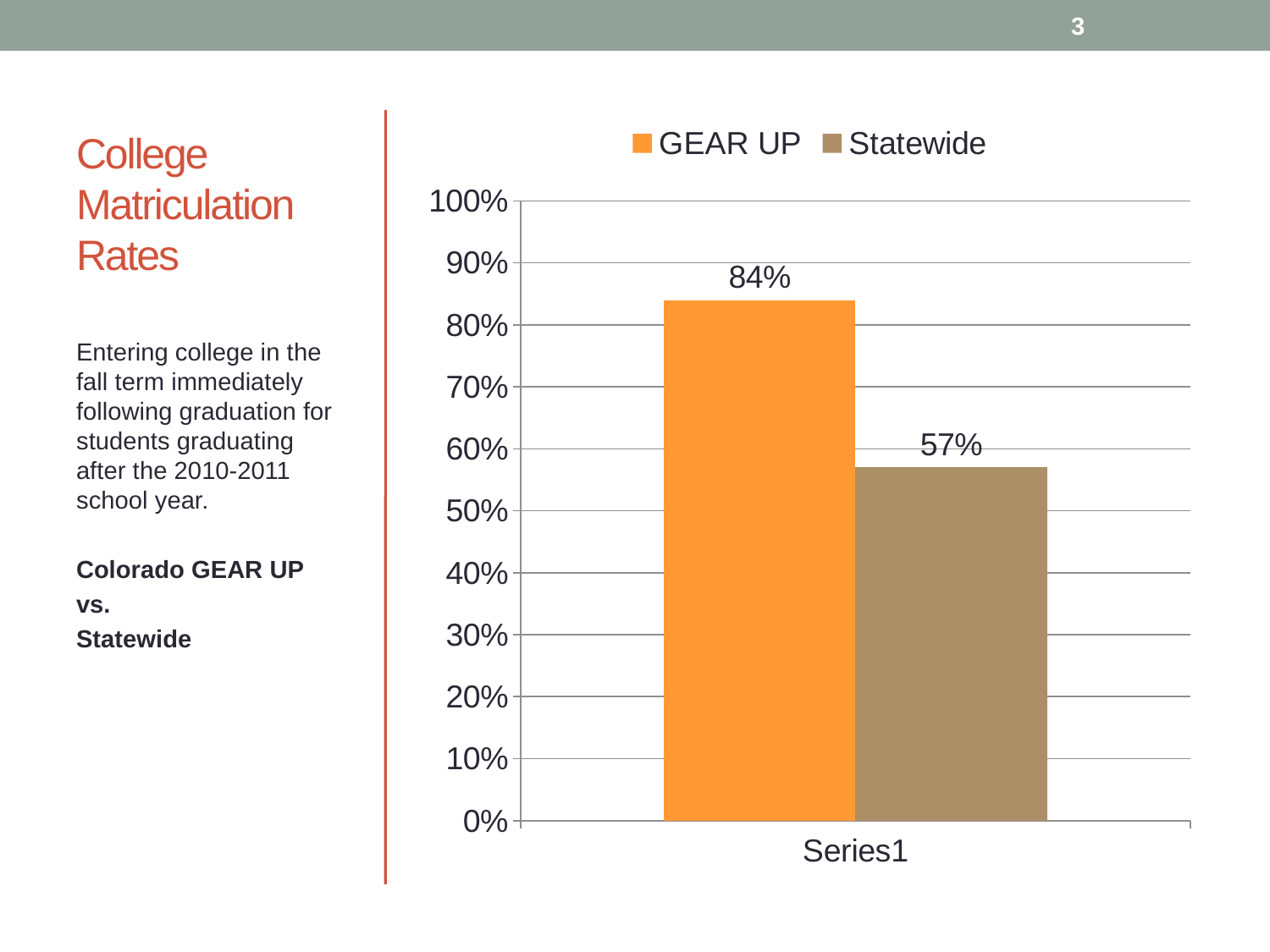
Which series has the lowest value on the chart? Statewide Is the value for Statewide greater or less than 60%? less What is the college matriculation rate for Statewide? 57% What is the difference between the GEAR UP and Statewide values? 27% Is the value for GEAR UP greater or less than 80%? greater What kind of chart is shown on the slide? bar chart What colour is the GEAR UP bar? orange What is the college matriculation rate for GEAR UP? 84% What is the label on the x axis category? Series1 How many series does the legend list? 2 What is the highest value shown on the y axis? 100% Which series has the higher value, GEAR UP or Statewide? GEAR UP